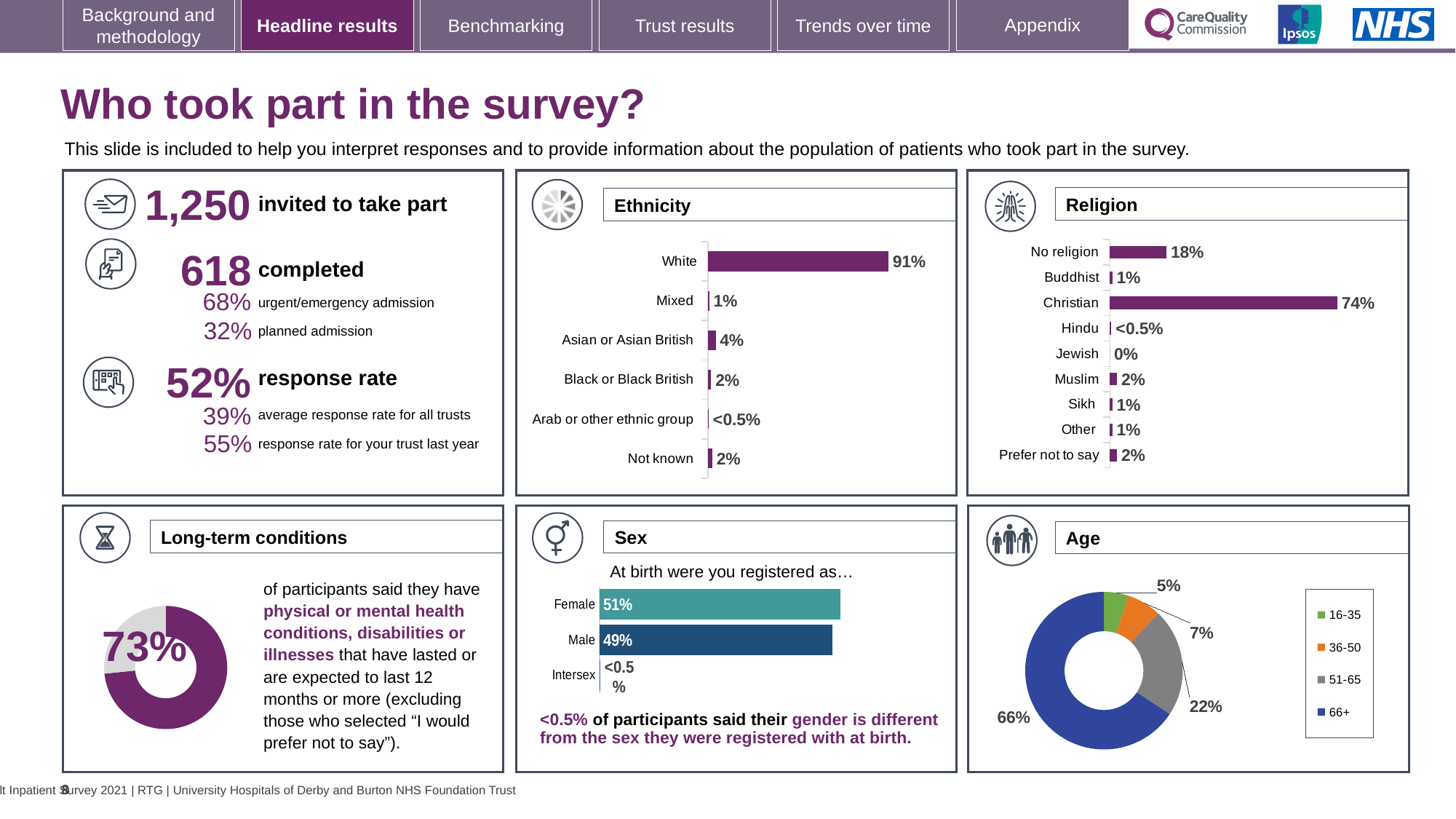
In the Religion chart, what is the difference between the Christian and No religion values? 56% How many categories are shown in the Religion chart? 9 In the Sex chart, what percentage of participants were registered as Male at birth? 49% In the Age chart, what share of participants were aged 66+? 66% In the Ethnicity chart, what is the value for Asian or Asian British? 4% In the Religion chart, what is the value for No religion? 18% What kind of chart is the Age chart? Doughnut chart In the Ethnicity chart, what percentage of participants were White? 91% In the Sex chart, which is larger, Female or Male? Female In the Religion chart, what percentage of participants were Christian? 74% In the Ethnicity chart, which category has the highest value? White In the Age chart, which age group has the smallest share? 16-35